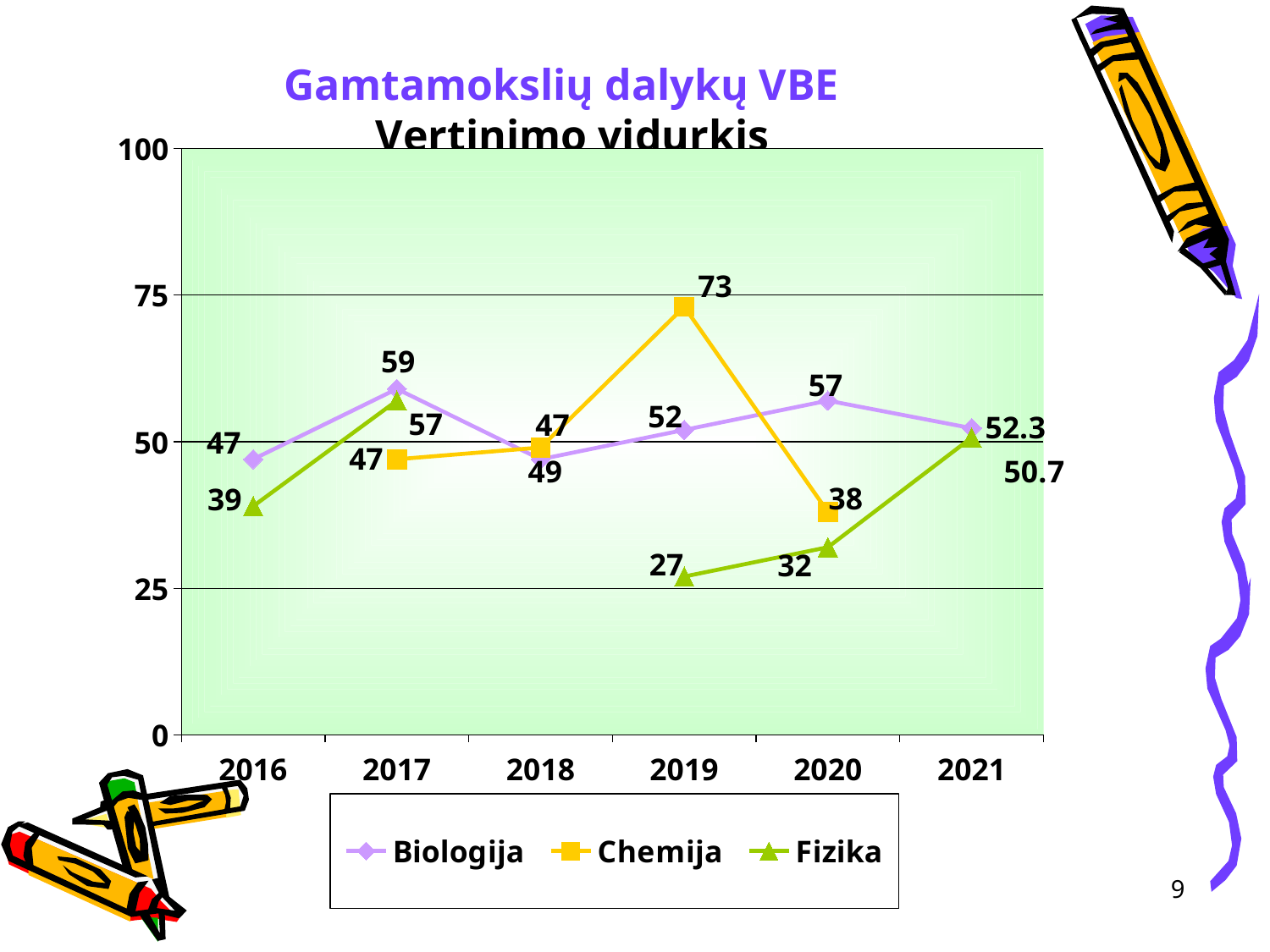
Which series has the larger value in 2019, Chemija or Biologija? Chemija In which year does Chemija reach its highest value? 2019 How many series does the legend list? 3 What is the value for Biologija in 2017? 59 What is the value for Chemija in 2019? 73 What is the value for Biologija in 2021? 52.3 What is the value for Fizika in 2019? 27 What kind of chart is shown on the slide? line chart What is the difference between Biologija and Chemija in 2020? 19 In which year does Fizika have its lowest value? 2019 What is the value for Fizika in 2021? 50.7 How many years are shown on the x axis? 6